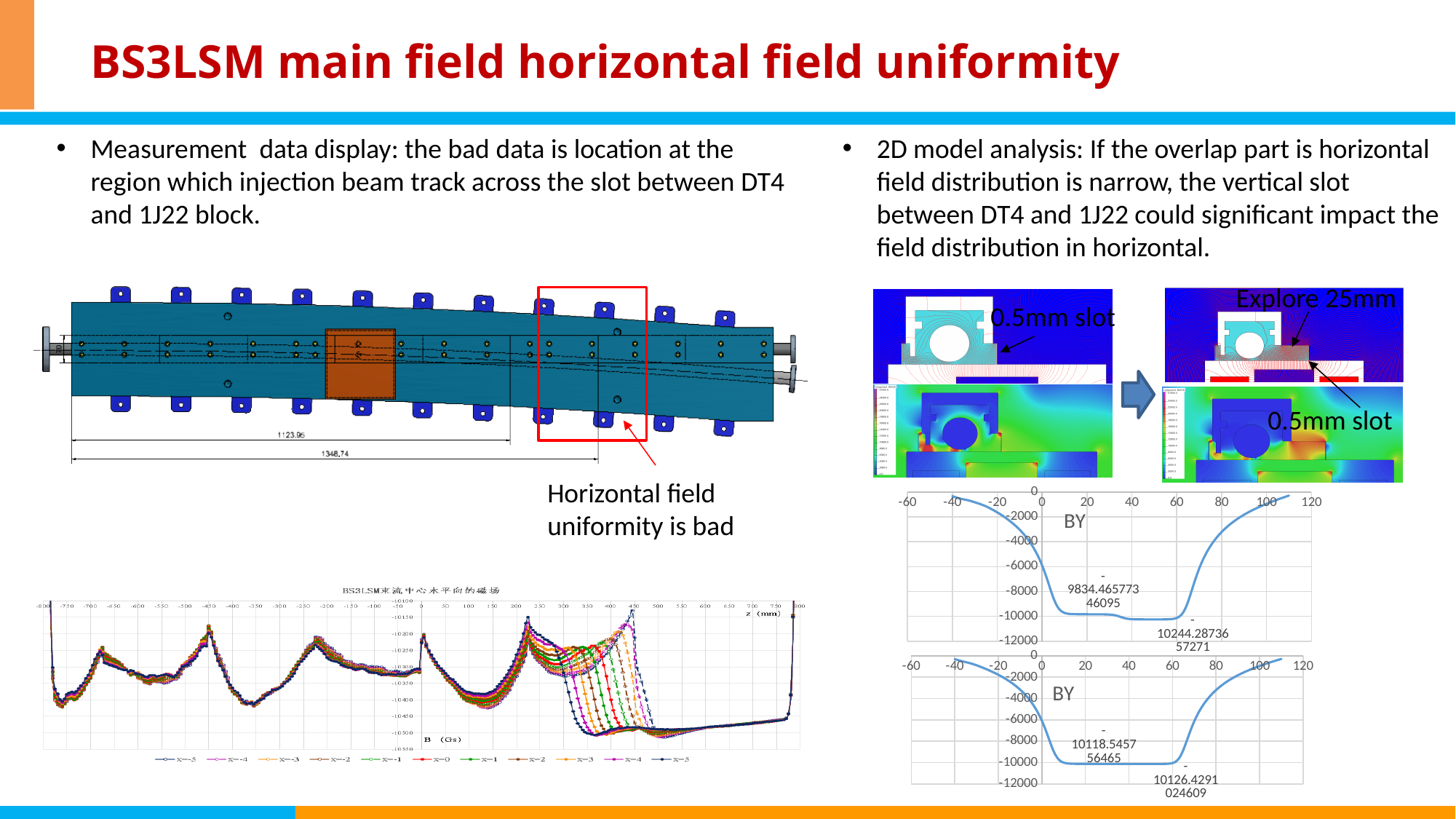
In the upper BY chart on the right, do the values rise or fall along the x axis between 60 and 100? rise In the bottom-left chart, what is the label of the horizontal axis? z (mm) How many series does the legend of the bottom-left chart list? 11 What is the name of the series plotted in the two charts on the right side of the slide? BY In the lower BY chart on the right, what is the first (left) data label value shown on the flat bottom of the curve? -10118.545756465 In the upper BY chart on the right, what is the difference between the two labeled values? 409.82159226615 In the upper BY chart on the right, which of the two labeled values is larger? -9834.46577346095 In the upper BY chart on the right, what is the second (right) data label value shown on the flat bottom of the curve? -10244.2873657271 In the lower BY chart on the right, what is the difference between the two labeled values? 7.8833459959 What kind of chart is the bottom-left chart titled 'BS3LSM束流中心水平向的磁场'? line chart In the lower BY chart on the right, what is the second (right) data label value shown on the flat bottom of the curve? -10126.4291024609 In the upper BY chart on the right, what is the first (left) data label value shown on the flat bottom of the curve? -9834.46577346095